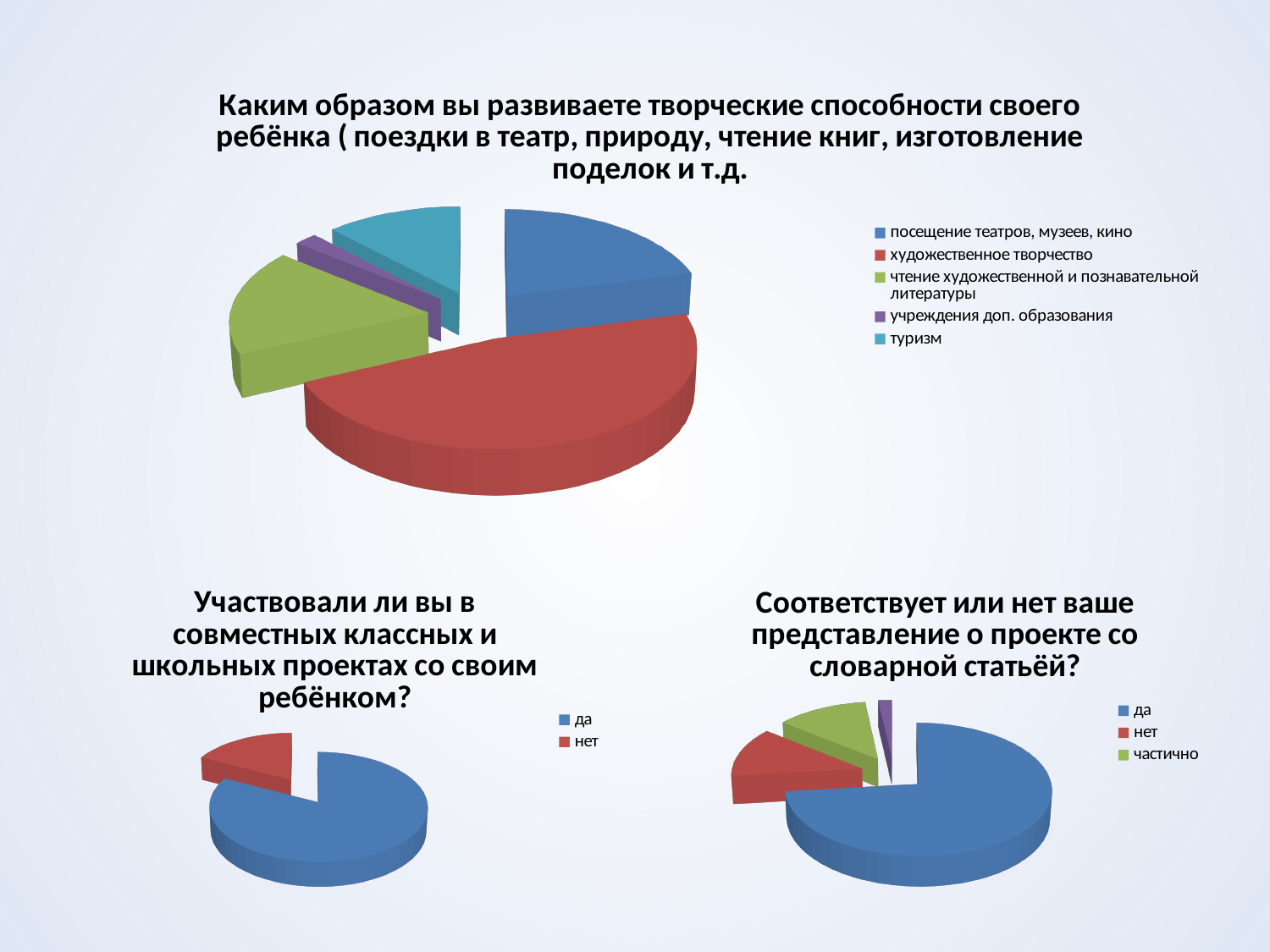
How many entries does the legend of the bottom-right chart "Соответствует или нет ваше представление о проекте со словарной статьёй?" list? 3 How many pie charts are on the slide? 3 In the top chart about developing the child's creative abilities, which slice is larger: "посещение театров, музеев, кино" or "туризм"? посещение театров, музеев, кино In the top chart about developing the child's creative abilities, which category has the smallest slice? учреждения доп. образования In the top chart about developing the child's creative abilities, what colour is the slice for "чтение художественной и познавательной литературы"? Green What type of chart is used for the question "Каким образом вы развиваете творческие способности своего ребёнка"? Pie chart In the bottom-left chart "Участвовали ли вы в совместных классных и школьных проектах со своим ребёнком?", which answer has the larger slice? да In the top chart about developing the child's creative abilities, which category has the largest slice? художественное творчество What type of chart is the bottom-left chart "Участвовали ли вы в совместных классных и школьных проектах со своим ребёнком?"? Pie chart How many categories are shown in the bottom-left chart "Участвовали ли вы в совместных классных и школьных проектах со своим ребёнком?"? 2 In the bottom-right chart "Соответствует или нет ваше представление о проекте со словарной статьёй?", which answer has the largest slice? да How many categories does the legend of the top chart about developing the child's creative abilities list? 5